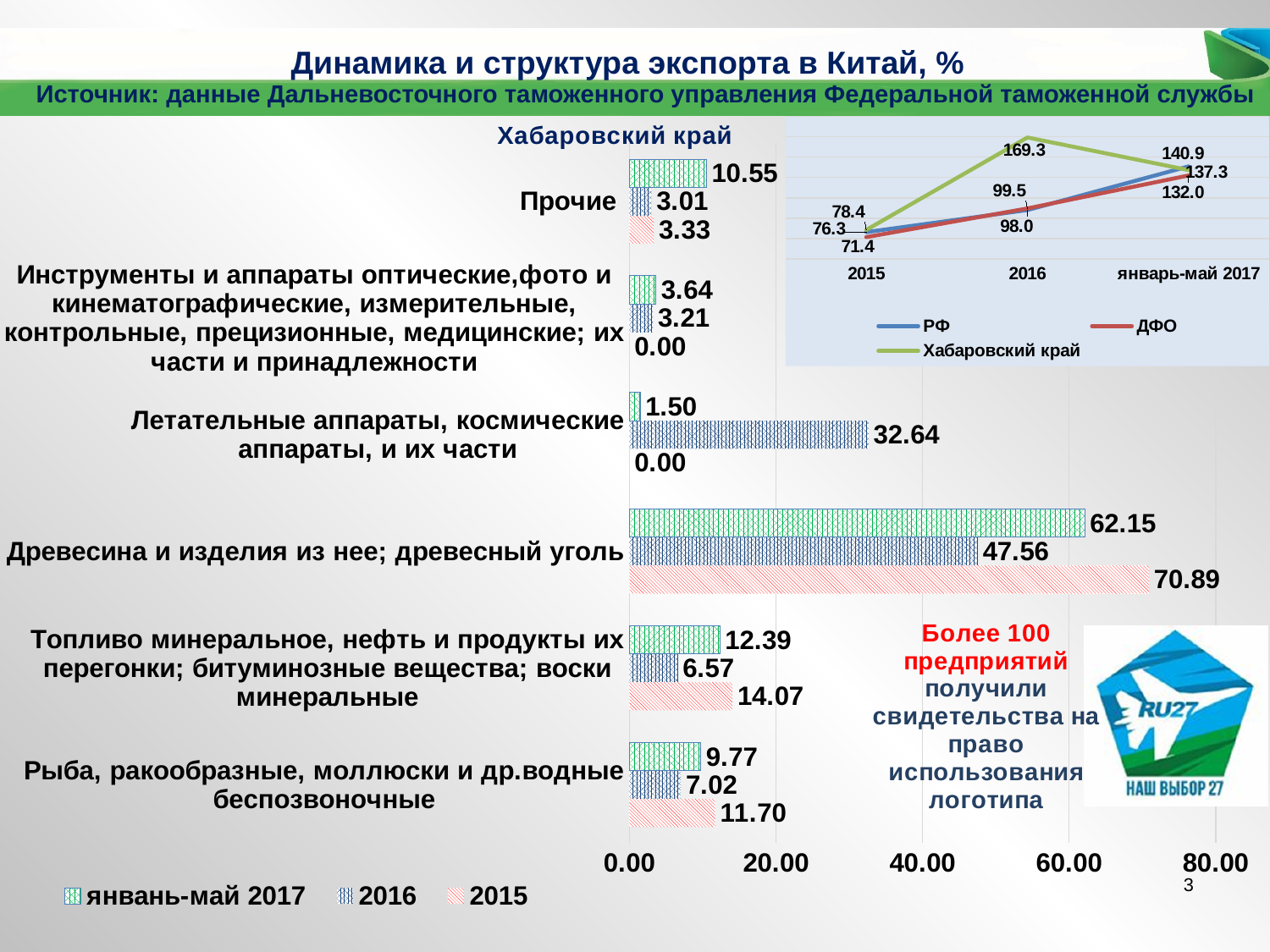
On the line chart in the top right, what is the value for 'Хабаровский край' in 2016? 169.3 On the bar chart 'Хабаровский край', what is the value for 'Летательные аппараты, космические аппараты, и их части' in the 2016 series? 32.64 On the line chart in the top right, how many series does the legend list? 3 On the bar chart 'Хабаровский край', what is the value for 'Древесина и изделия из нее; древесный уголь' in the 2015 series? 70.89 On the line chart in the top right, what is the value for 'Хабаровский край' in январь-май 2017? 137.3 On the bar chart 'Хабаровский край', how many series does the legend list? 3 On the bar chart 'Хабаровский край', what is the value for 'Прочие' in the январь-май 2017 series? 10.55 On the bar chart 'Хабаровский край', how many categories are shown? 6 On the bar chart 'Хабаровский край', what is the difference between the 2015 and январь-май 2017 values for 'Древесина и изделия из нее; древесный уголь'? 8.74 On the bar chart 'Хабаровский край', which is larger for 'Топливо минеральное, нефть и продукты их перегонки; битуминозные вещества; воски минеральные': the 2015 value or the 2016 value? 2015 What kind of chart is the chart titled 'Хабаровский край'? Bar chart On the bar chart 'Хабаровский край', which category has the highest value in the январь-май 2017 series? Древесина и изделия из нее; древесный уголь